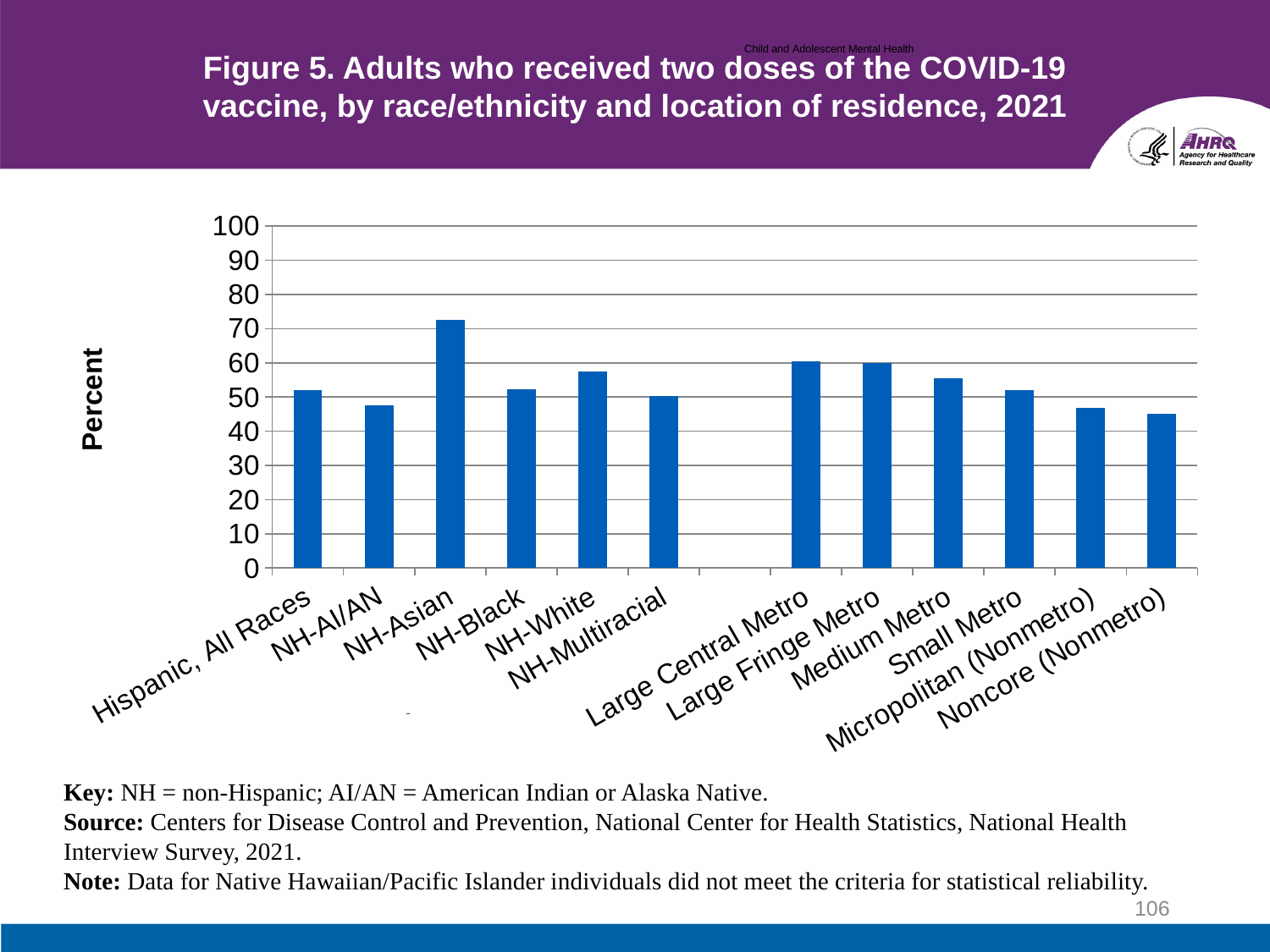
Is the value for Noncore (Nonmetro) greater or less than 50? less What is the label on the vertical axis of the chart? Percent Is the value for NH-Asian greater or less than 70? greater What year of data does the chart title say it shows? 2021 How many categories (bars) are plotted in the chart? 12 Is the value for NH-AI/AN greater or less than 50? less What kind of chart is shown on the slide? Bar chart Which is larger, the value for Large Central Metro or the value for Noncore (Nonmetro)? Large Central Metro Which category has the highest value in the chart? NH-Asian Which is larger, the value for NH-White or the value for NH-Black? NH-White Across the location-of-residence categories from Large Central Metro to Noncore (Nonmetro), do the values rise or fall? fall